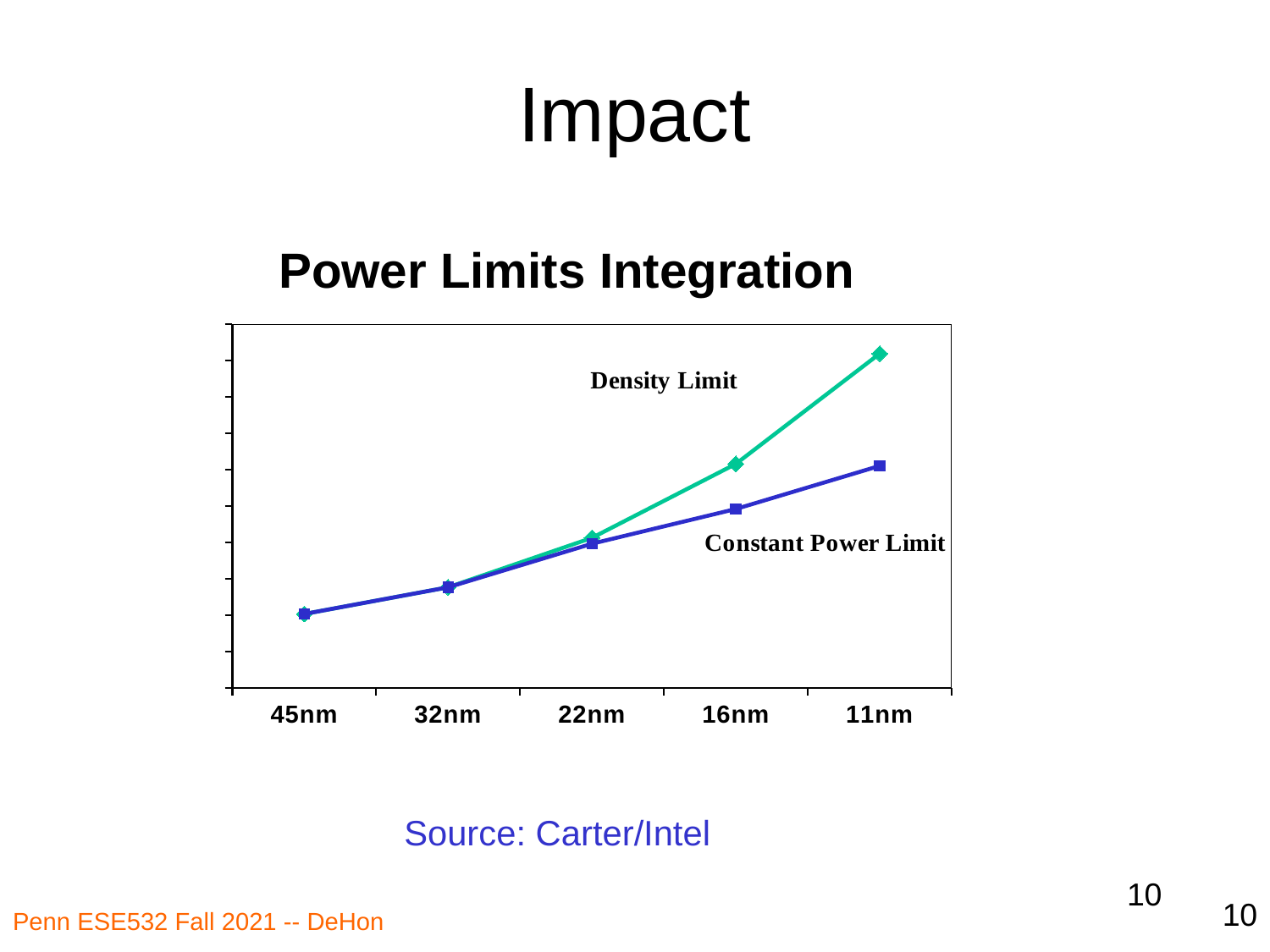
At which process node does the Constant Power Limit series have its lowest value? 45nm How many process nodes are shown along the x axis of the chart? 5 What is the title of the chart? Power Limits Integration Does the Constant Power Limit series rise or fall as the x axis moves from 45nm to 11nm? rise Does the Density Limit series rise or fall as the x axis moves from 45nm to 11nm? rise How many data series are plotted in the chart? 2 At 16nm, which series has the higher value, Density Limit or Constant Power Limit? Density Limit At which process node does the Density Limit series reach its highest value? 11nm What kind of chart is shown on the slide? line chart What are the names of the two series plotted in the chart? Density Limit and Constant Power Limit At 11nm, which series has the higher value, Density Limit or Constant Power Limit? Density Limit Which process node is the first label on the x axis of the chart? 45nm